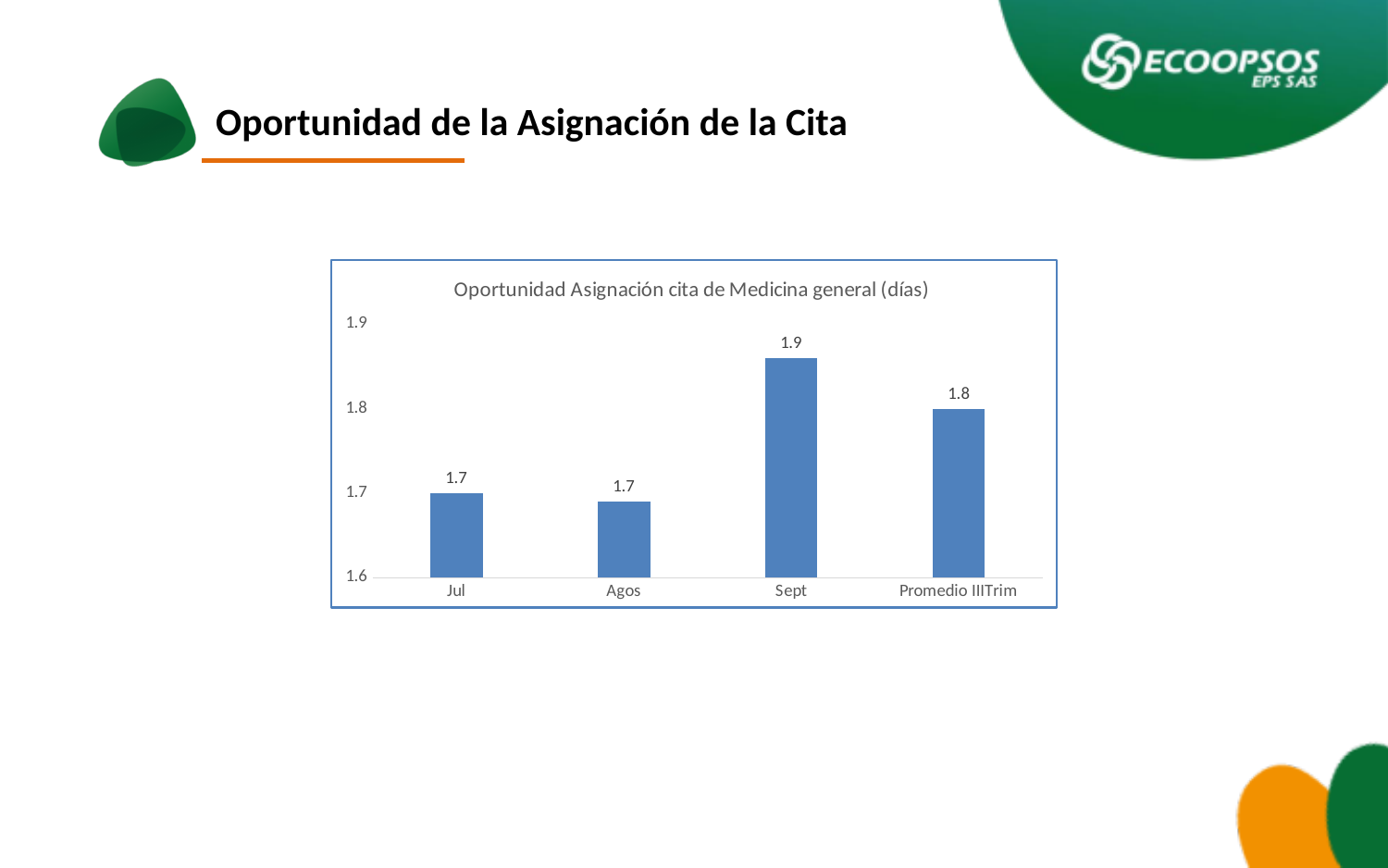
Which is larger, the value for Sept or the value for Promedio IIITrim? Sept What type of chart is shown on the slide? bar chart Is the value for Sept greater or less than 1.8? greater What is the title of the chart? Oportunidad Asignación cita de Medicina general (días) How many categories are shown on the x axis? 4 Which category has the highest value? Sept What is the difference between the values for Sept and Jul? 0.2 Does the value rise or fall from Agos to Sept? rise What is the value for Sept? 1.9 What is the value for Promedio IIITrim? 1.8 What is the value for Jul? 1.7 What is the value for Agos? 1.7